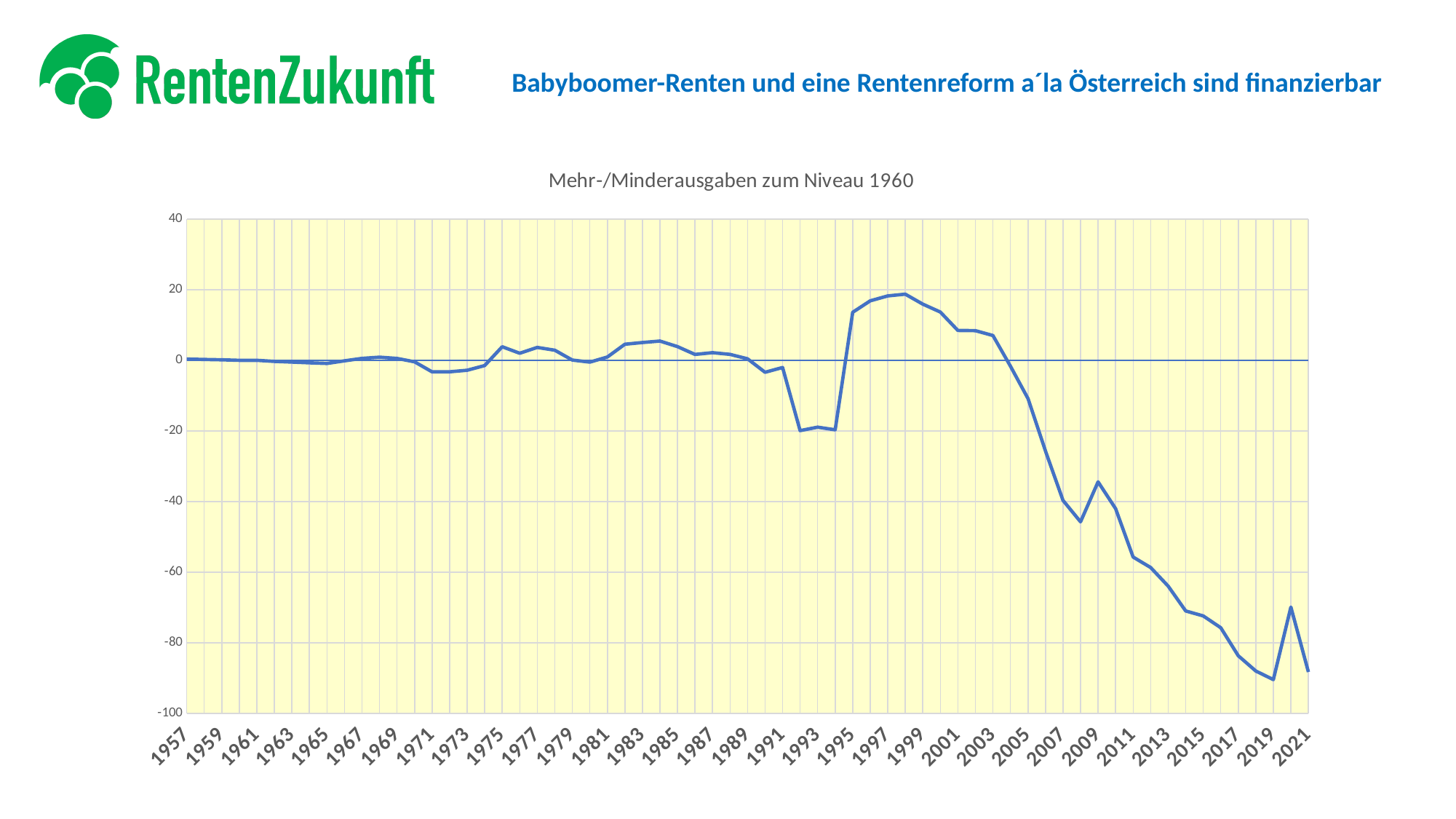
Is the value for 2005 greater or less than -20? greater Is the value for 1997 greater or less than 0? greater Do the values rise or fall between 2003 and 2019? fall Is the value for 2021 greater or less than -80? less What kind of chart is shown on the slide? line chart Which year has the larger value, 2009 or 2011? 2009 Which year has the larger value, 1997 or 2021? 1997 What is the lowest value shown on the vertical axis? -100 What is the title of the chart? Mehr-/Minderausgaben zum Niveau 1960